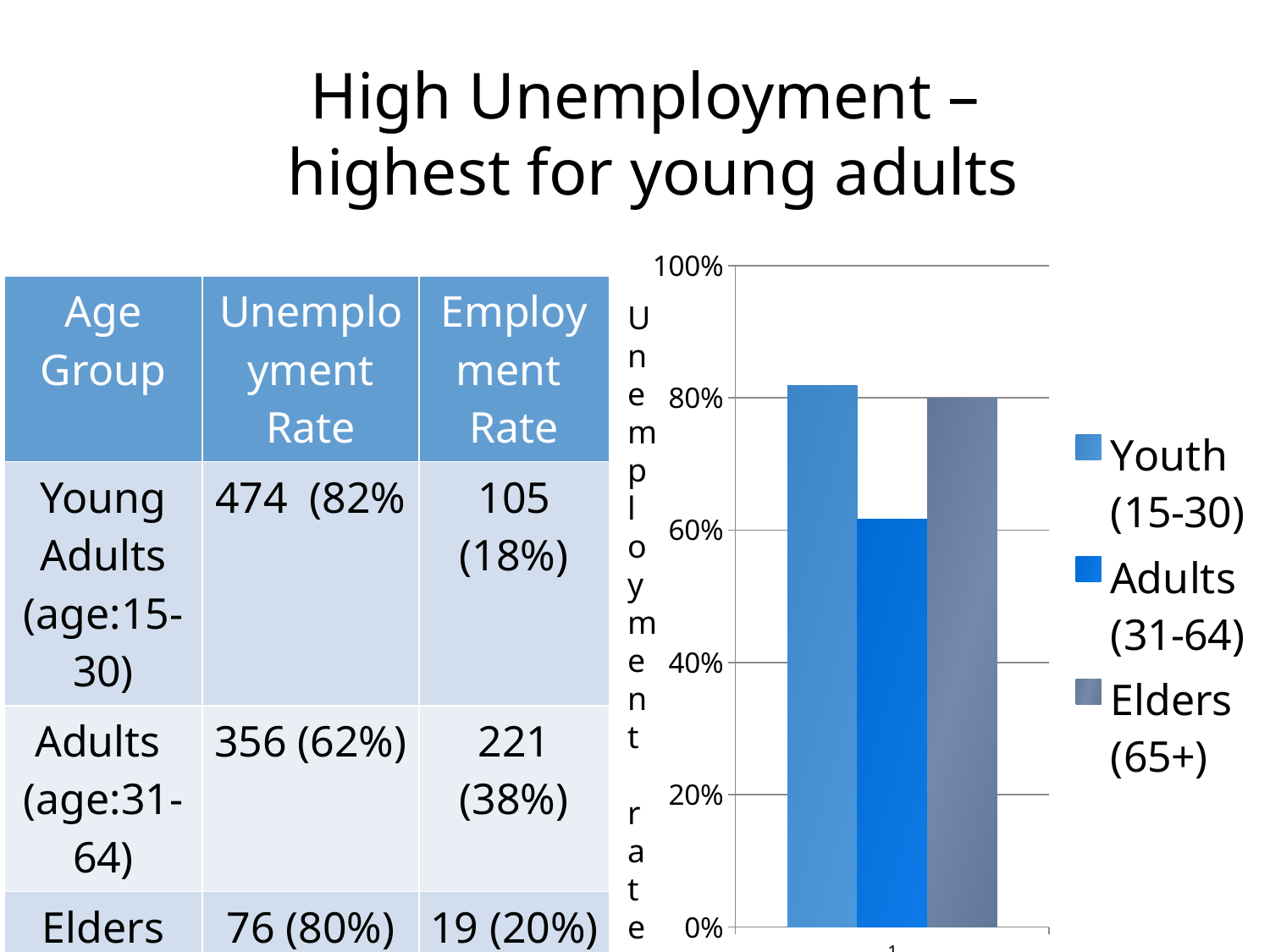
What is the title of the chart's vertical axis? Unemployment rate Which series has the lowest unemployment rate in the chart? Adults (31-64) How many series does the chart's legend list? 3 Which is larger in the chart, the unemployment rate for Elders (65+) or for Adults (31-64)? Elders (65+) What kind of chart is shown on the slide? bar chart Which is larger in the chart, the unemployment rate for Youth (15-30) or for Adults (31-64)? Youth (15-30) Is the unemployment rate for Youth (15-30) greater or less than 80%? greater What is the highest value shown on the chart's vertical axis? 100% Is the unemployment rate for Adults (31-64) greater or less than 80%? less What unemployment rate does the Elders (65+) bar reach on the chart? 80% Which series has the highest unemployment rate in the chart? Youth (15-30) Is the unemployment rate for Adults (31-64) greater or less than 60%? greater